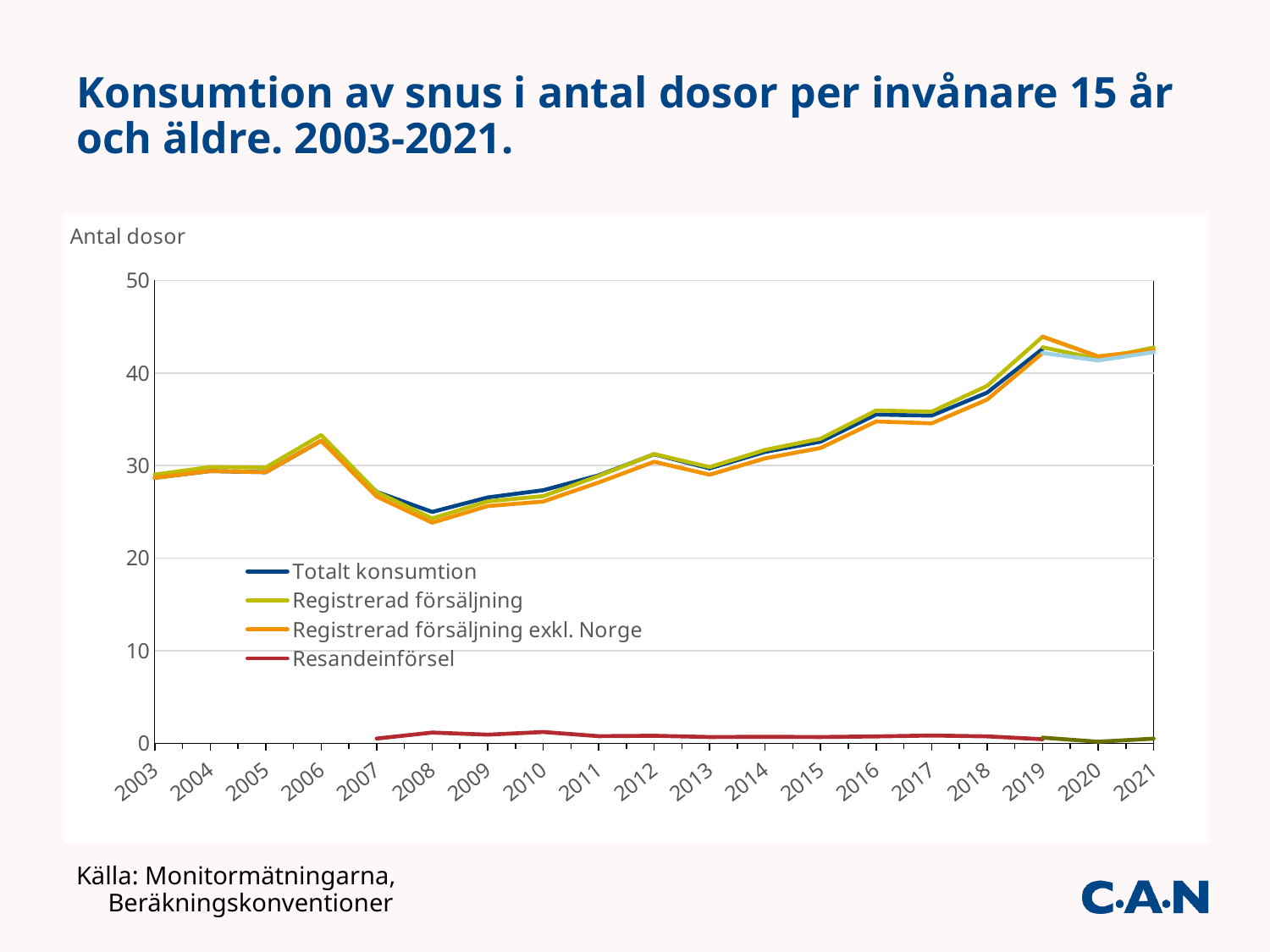
Which is larger for Totalt konsumtion, the value in 2019 or the value in 2008? 2019 Is the value for Totalt konsumtion in 2008 greater or less than 30? less How many years are shown along the x axis? 19 How many series does the legend list? 4 Is the value for Totalt konsumtion in 2006 greater or less than 30? greater What kind of chart is shown on the slide? line chart Which series has the lowest values throughout the chart? Resandeinförsel In which year is Totalt konsumtion at its lowest? 2008 What is the title of the chart? Konsumtion av snus i antal dosor per invånare 15 år och äldre. 2003-2021. Is the value for Totalt konsumtion in 2019 greater or less than 40? greater What is the label on the y axis? Antal dosor